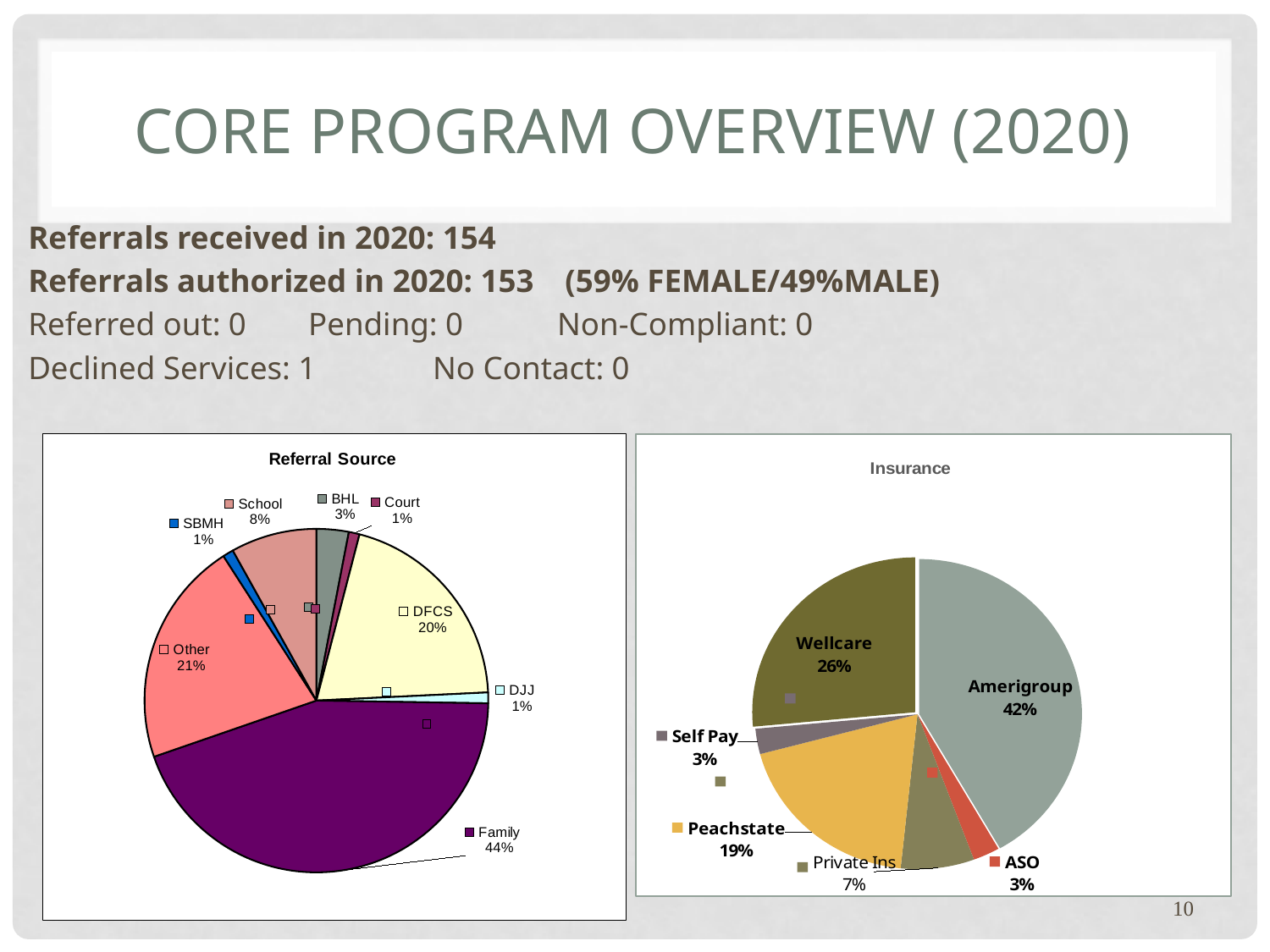
In the Referral Source chart, which is larger, Other or School? Other In the Referral Source chart, which referral source has the largest share? Family In the Insurance chart, how many insurance categories are shown? 6 In the Referral Source chart, what share of referrals came from Family? 44% In the Referral Source chart, what is the difference between the Family share and the Other share? 23% In the Insurance chart, what is the difference between the Wellcare share and the Private Ins share? 19% In the Referral Source chart, what percentage is shown for DFCS? 20% In the Referral Source chart, how many referral source categories are shown? 8 In the Insurance chart, which insurance category has the largest share? Amerigroup In the Insurance chart, what percentage is shown for Peachstate? 19% What type of chart is the Insurance chart? Pie chart In the Insurance chart, what share is shown for Amerigroup? 42%